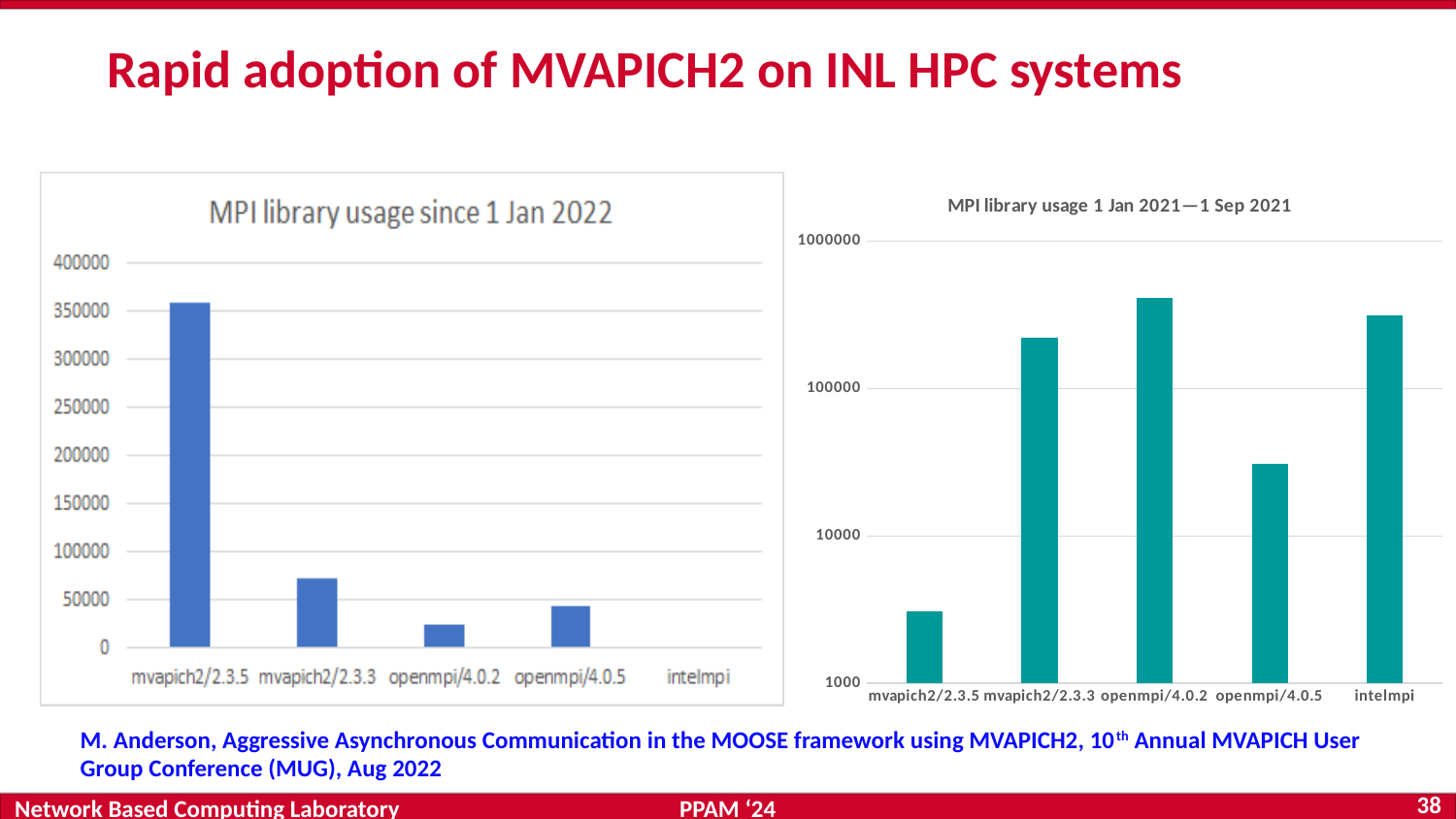
In the chart titled "MPI library usage 1 Jan 2021—1 Sep 2021", is the value for intelmpi greater or less than 100000? greater In the chart titled "MPI library usage since 1 Jan 2022", is the value for mvapich2/2.3.3 greater or less than 100000? less In the chart titled "MPI library usage 1 Jan 2021—1 Sep 2021", which library has the highest usage? openmpi/4.0.2 What is the title of the chart on the right side of the slide? MPI library usage 1 Jan 2021—1 Sep 2021 In the chart titled "MPI library usage since 1 Jan 2022", how many MPI library categories are shown on the x axis? 5 In the chart titled "MPI library usage since 1 Jan 2022", what kind of chart is shown? bar chart In the chart titled "MPI library usage 1 Jan 2021—1 Sep 2021", which library has the lowest usage? mvapich2/2.3.5 In the chart titled "MPI library usage since 1 Jan 2022", which library has the highest usage? mvapich2/2.3.5 In the chart titled "MPI library usage since 1 Jan 2022", is the value for mvapich2/2.3.5 greater or less than 300000? greater In the chart titled "MPI library usage since 1 Jan 2022", which is larger, the value for openmpi/4.0.2 or openmpi/4.0.5? openmpi/4.0.5 In the chart titled "MPI library usage 1 Jan 2021—1 Sep 2021", which is larger, the value for mvapich2/2.3.3 or openmpi/4.0.5? mvapich2/2.3.3